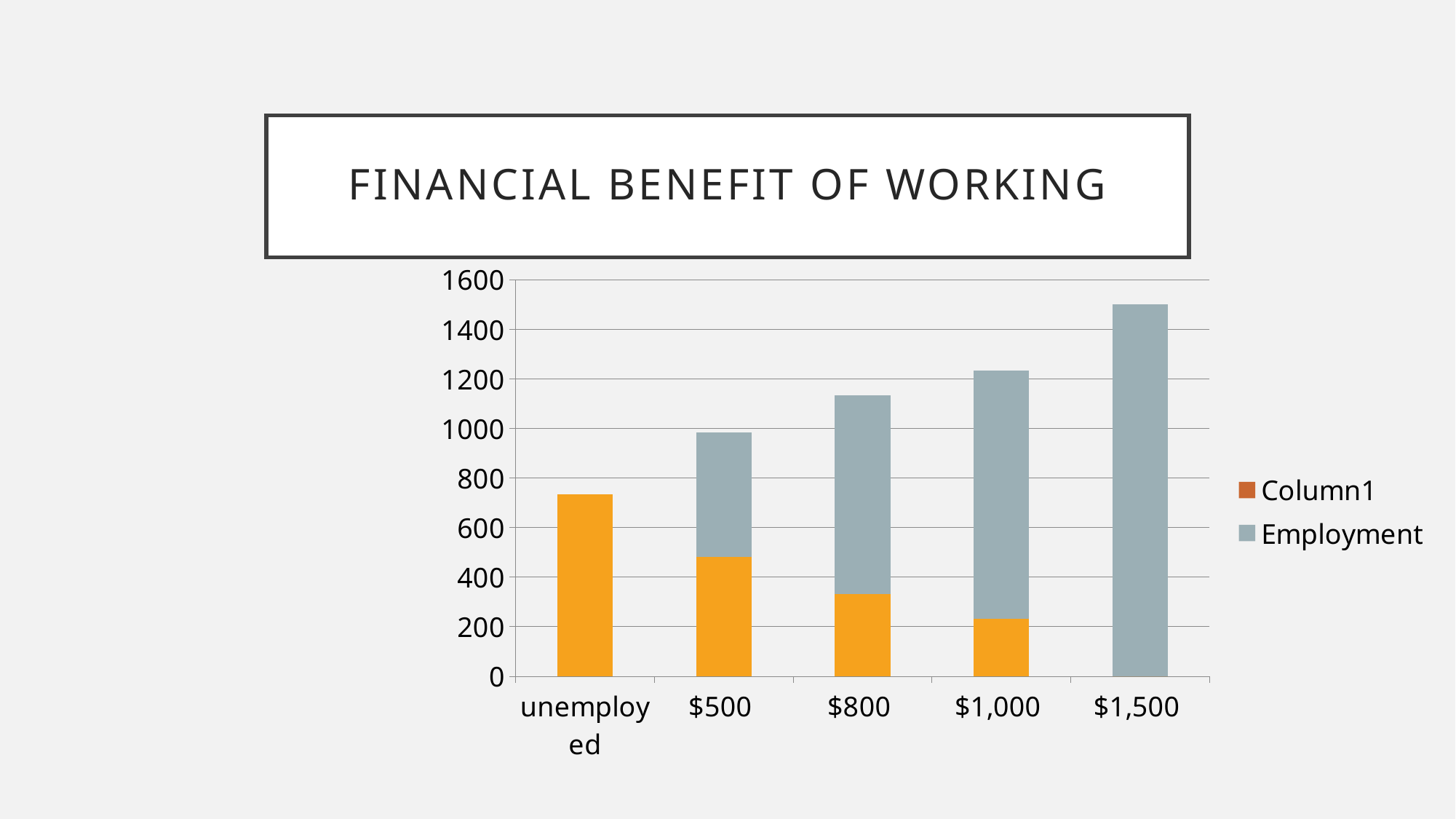
What is the title of the slide? FINANCIAL BENEFIT OF WORKING How many series does the legend list? 2 Do the total bar heights rise or fall from left to right along the x axis? rise How many categories are shown on the x axis? 5 Which has the taller total bar, $800 or $500? $800 Is the total bar height for $800 greater or less than 1000? greater What kind of chart is shown on the slide? bar chart Is the total bar height for unemployed greater or less than 800? less Which category has the shortest bar? unemployed Which category has the tallest bar? $1,500 Is the total bar height for $1,500 greater or less than 1400? greater